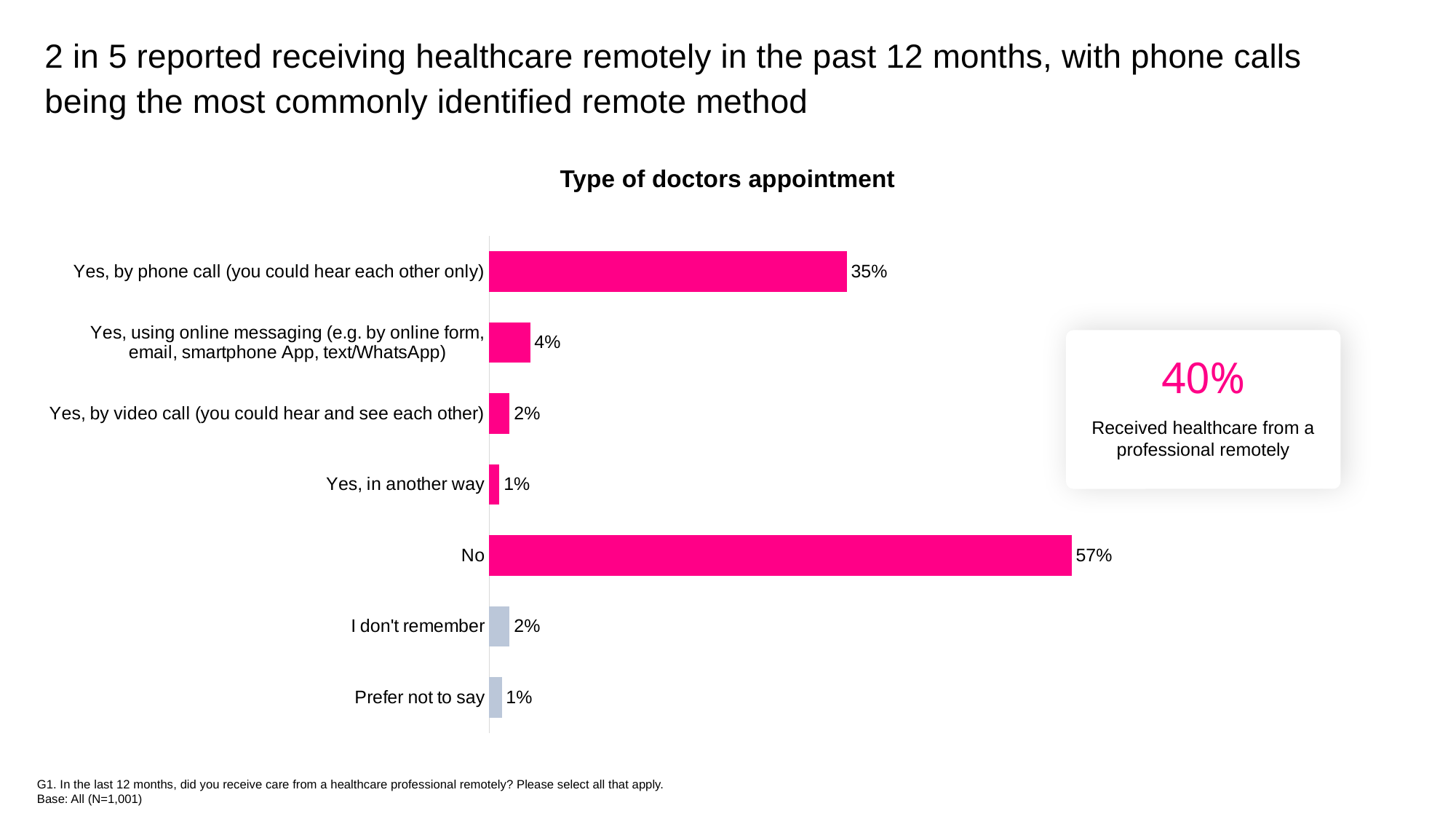
What is the value for 'Yes, by video call (you could hear and see each other)'? 2% Which 'Yes' response has the highest value? Yes, by phone call (you could hear each other only) Which category has the highest value in the chart? No What percentage is shown in the callout box as having received healthcare from a professional remotely? 40% Which is larger: the value for online messaging or the value for video call? Online messaging How many categories are shown in the chart? 7 What percentage of respondents said they received healthcare by phone call? 35% What is the value for 'No' in the Type of doctors appointment chart? 57% What is the difference between the 'No' value and the 'Yes, by phone call' value? 22% What percentage reported receiving healthcare using online messaging? 4% What type of chart is shown on the slide? Bar chart What is the title of the chart? Type of doctors appointment